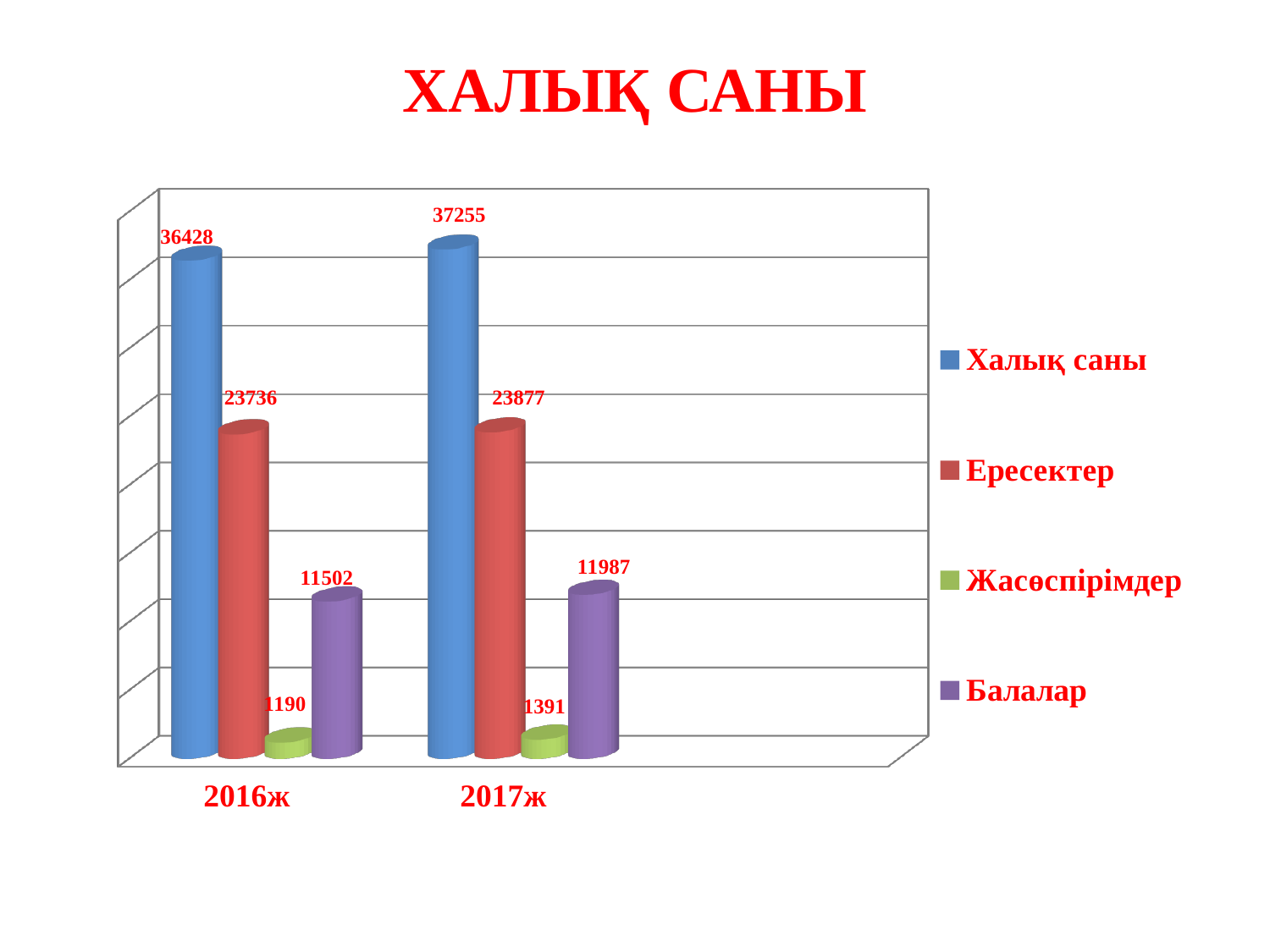
Which is larger, Балалар in 2016ж or Балалар in 2017ж? Балалар in 2017ж What is the value for Халық саны in 2016ж? 36428 What is the title of the slide? ХАЛЫҚ САНЫ How many series does the legend list? 4 What kind of chart is shown on the slide? Bar chart How many categories are shown on the x axis? 2 What is the difference between the Халық саны values for 2017ж and 2016ж? 827 What is the value for Балалар in 2017ж? 11987 What is the value for Ересектер in 2017ж? 23877 Which series has the highest value in 2016ж? Халық саны What is the value for Жасөспірімдер in 2016ж? 1190 Which series has the lowest value in 2017ж? Жасөспірімдер